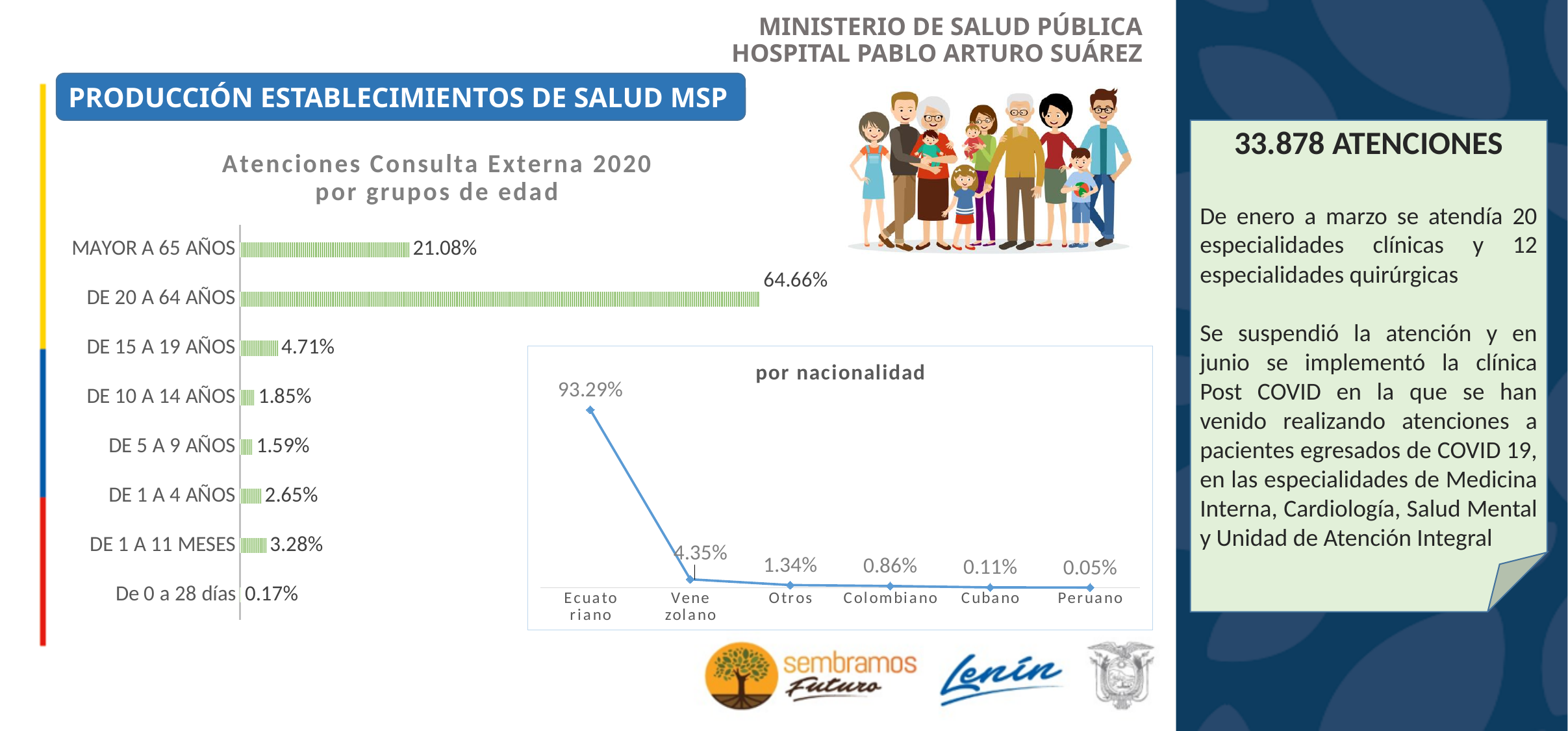
In the 'Atenciones Consulta Externa 2020 por grupos de edad' chart, how many age groups are shown? 8 In the 'Atenciones Consulta Externa 2020 por grupos de edad' chart, what is the difference between DE 20 A 64 AÑOS and MAYOR A 65 AÑOS? 43.58% What kind of chart is 'por nacionalidad'? Line chart What kind of chart is 'Atenciones Consulta Externa 2020 por grupos de edad'? Bar chart In the 'por nacionalidad' chart, which nationality has the lowest value? Peruano In the 'por nacionalidad' chart, what is the value for Ecuatoriano? 93.29% In the 'Atenciones Consulta Externa 2020 por grupos de edad' chart, which is larger: DE 1 A 4 AÑOS or DE 1 A 11 MESES? DE 1 A 11 MESES In the 'Atenciones Consulta Externa 2020 por grupos de edad' chart, which age group has the lowest value? De 0 a 28 días In the 'Atenciones Consulta Externa 2020 por grupos de edad' chart, what is the value for DE 20 A 64 AÑOS? 64.66% In the 'por nacionalidad' chart, how many nationality categories are plotted? 6 In the 'por nacionalidad' chart, what is the value for Colombiano? 0.86% In the 'Atenciones Consulta Externa 2020 por grupos de edad' chart, what is the value for MAYOR A 65 AÑOS? 21.08%